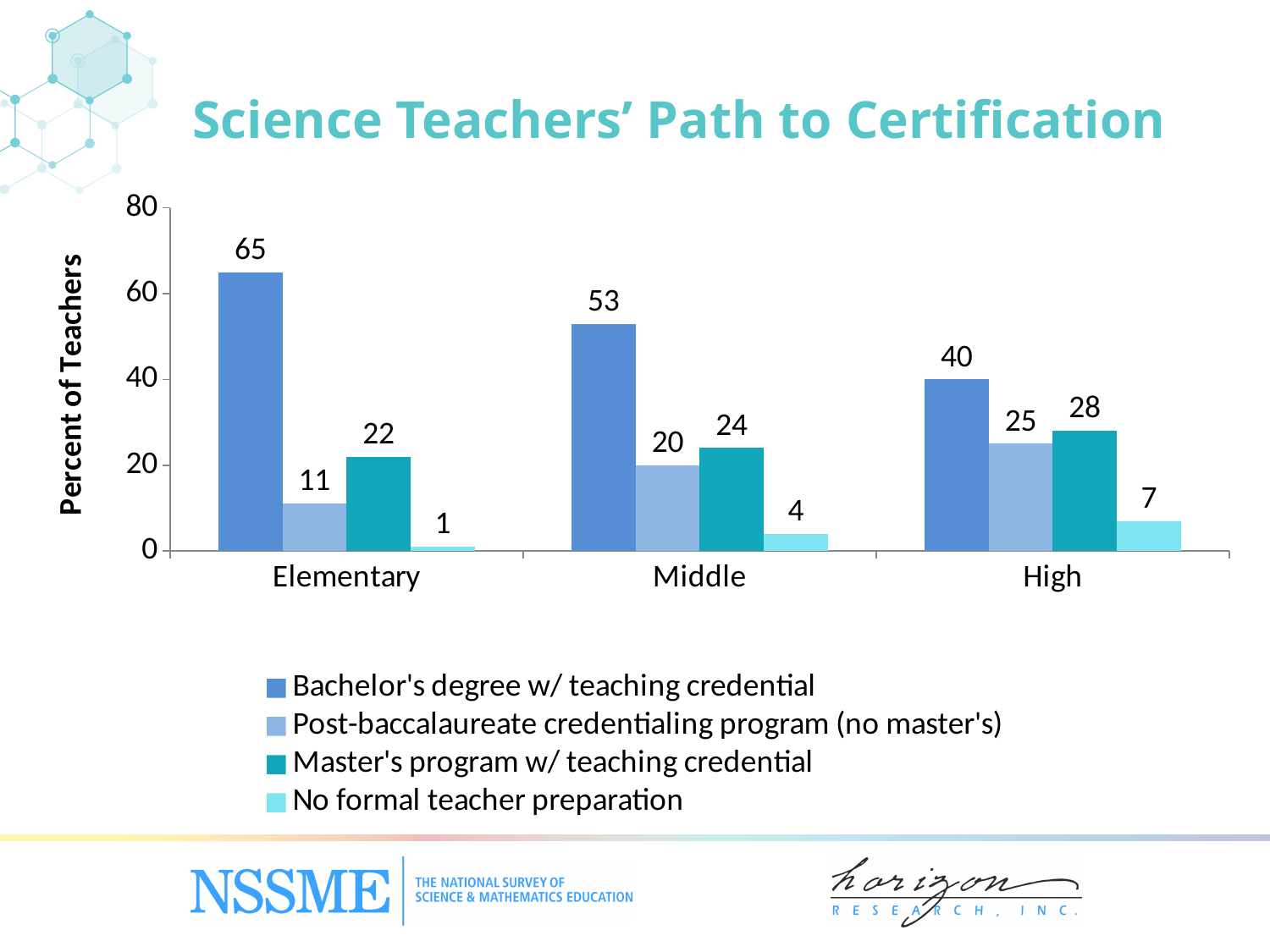
How many series does the legend list? 4 Is the value for high school teachers with a bachelor's degree with teaching credential greater or less than 60? less Which grade level has the lowest percent of teachers with no formal teacher preparation? Elementary What is the title of the chart? Science Teachers' Path to Certification Which is larger for middle school teachers: post-baccalaureate credentialing program or master's program with teaching credential? Master's program w/ teaching credential Which grade level has the highest percent of teachers with a bachelor's degree with teaching credential? Elementary What percent of elementary science teachers have a bachelor's degree with teaching credential? 65 What kind of chart is shown on the slide? Bar chart What percent of high school science teachers completed a master's program with teaching credential? 28 What is the difference between the percent of elementary and high school teachers with a bachelor's degree with teaching credential? 25 How many grade-level categories are shown on the x axis? 3 What percent of middle school science teachers have no formal teacher preparation? 4